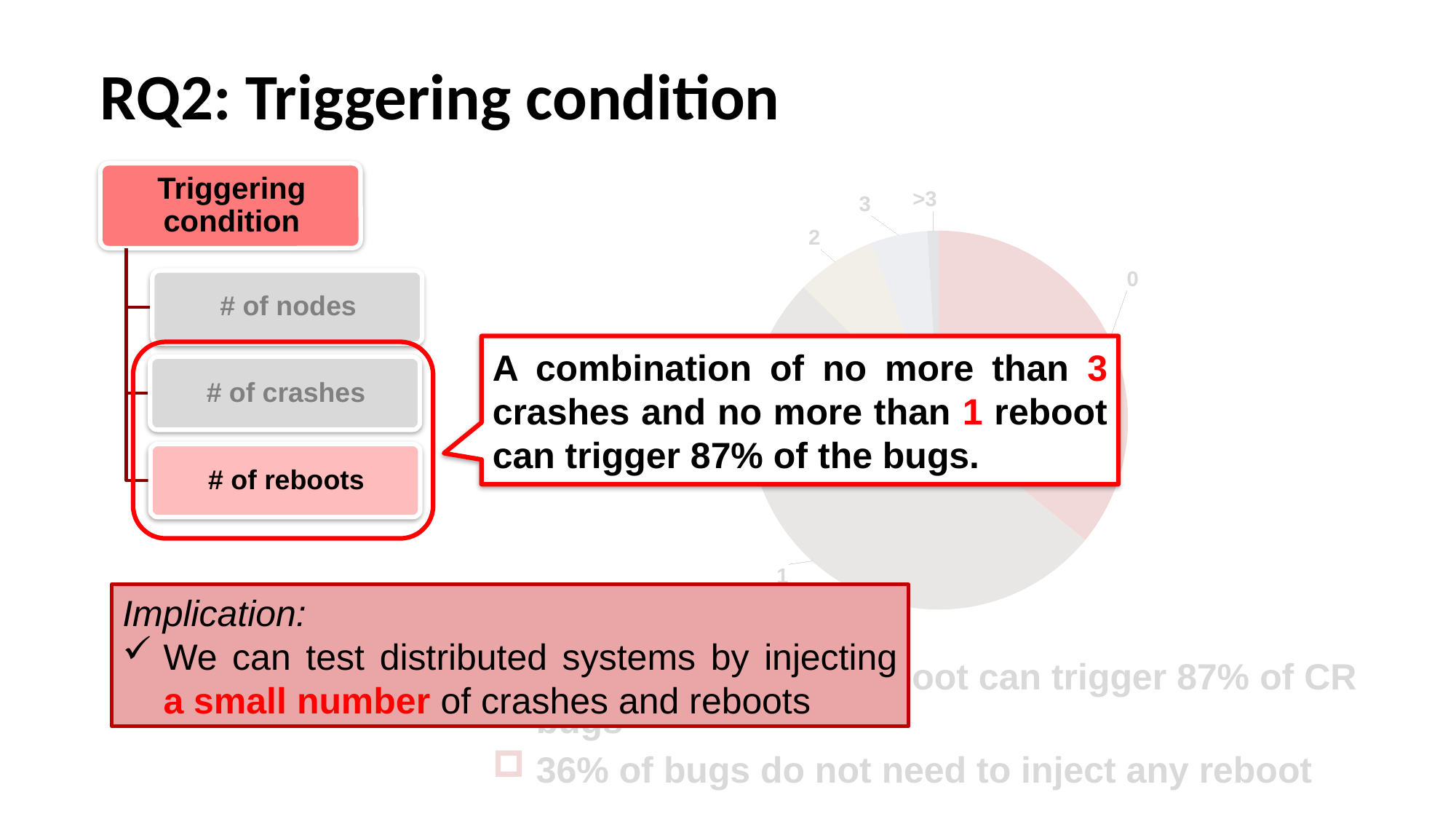
How many slices does the pie chart have? 5 Which slice of the pie chart is larger, the one labelled 2 or the one labelled >3? 2 What colour is the slice labelled 0 in the pie chart? red Which slice of the pie chart is larger, the one labelled 1 or the one labelled 3? 1 Which slice of the pie chart is larger, the one labelled 0 or the one labelled 2? 0 What kind of chart is shown on the slide? pie chart What are the labels of the slices in the pie chart? 0, 1, 2, 3, >3